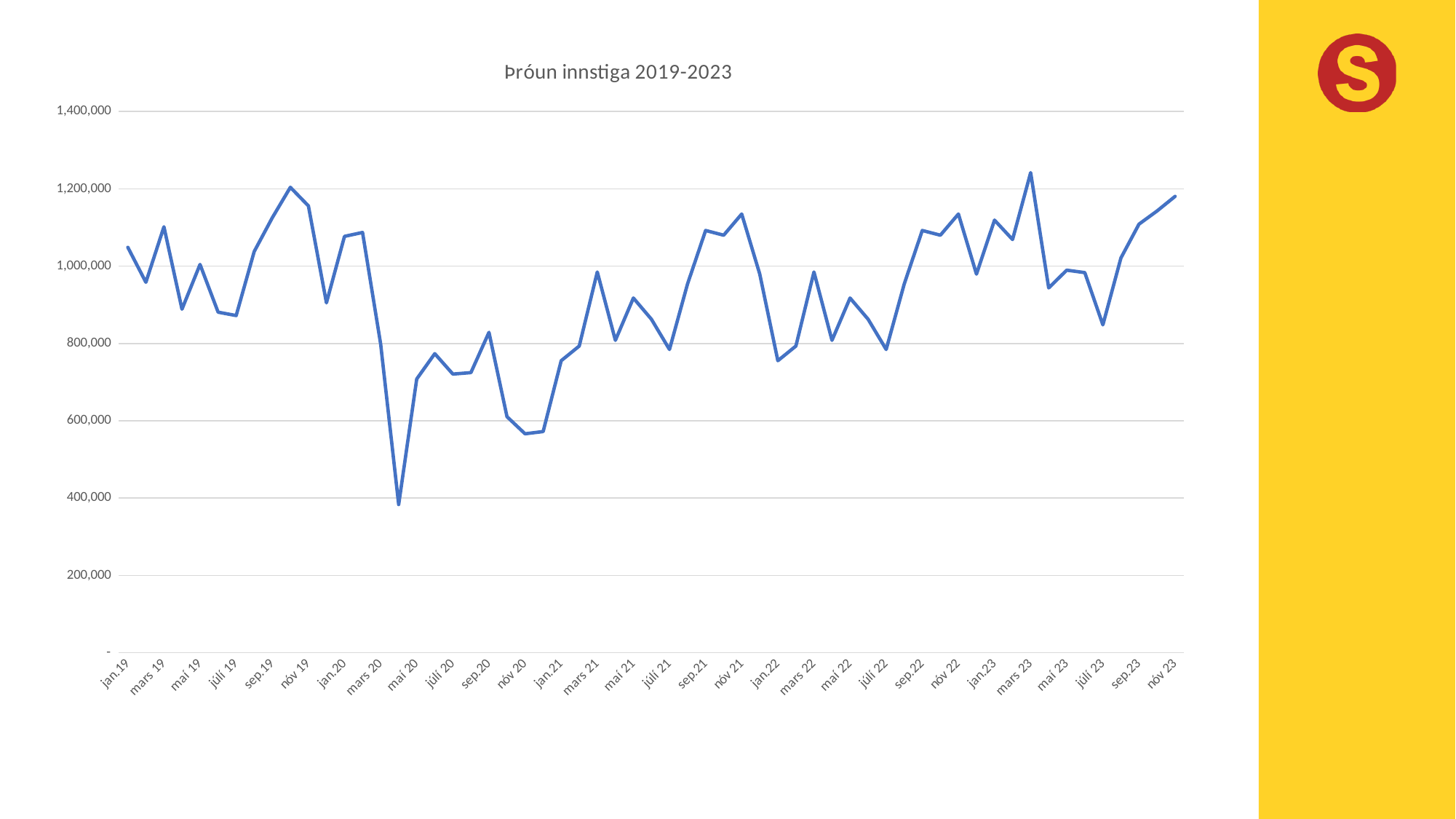
Which is larger, the value for nóv 19 or the value for nóv 20? nóv 19 Is the value for jan.19 greater or less than 1,000,000? greater Is the value for maí 20 greater or less than 800,000? less What kind of chart is shown on the slide? line chart Does the line rise or fall between jan.21 and mars 21? rise How many data series are plotted in the chart? 1 What is the title of the chart? Þróun innstiga 2019-2023 What is the highest value shown on the y axis? 1,400,000 Is the value for nóv 20 greater or less than 800,000? less Which is larger, the value for jan.19 or the value for maí 20? jan.19 How many month labels are shown on the x axis? 30